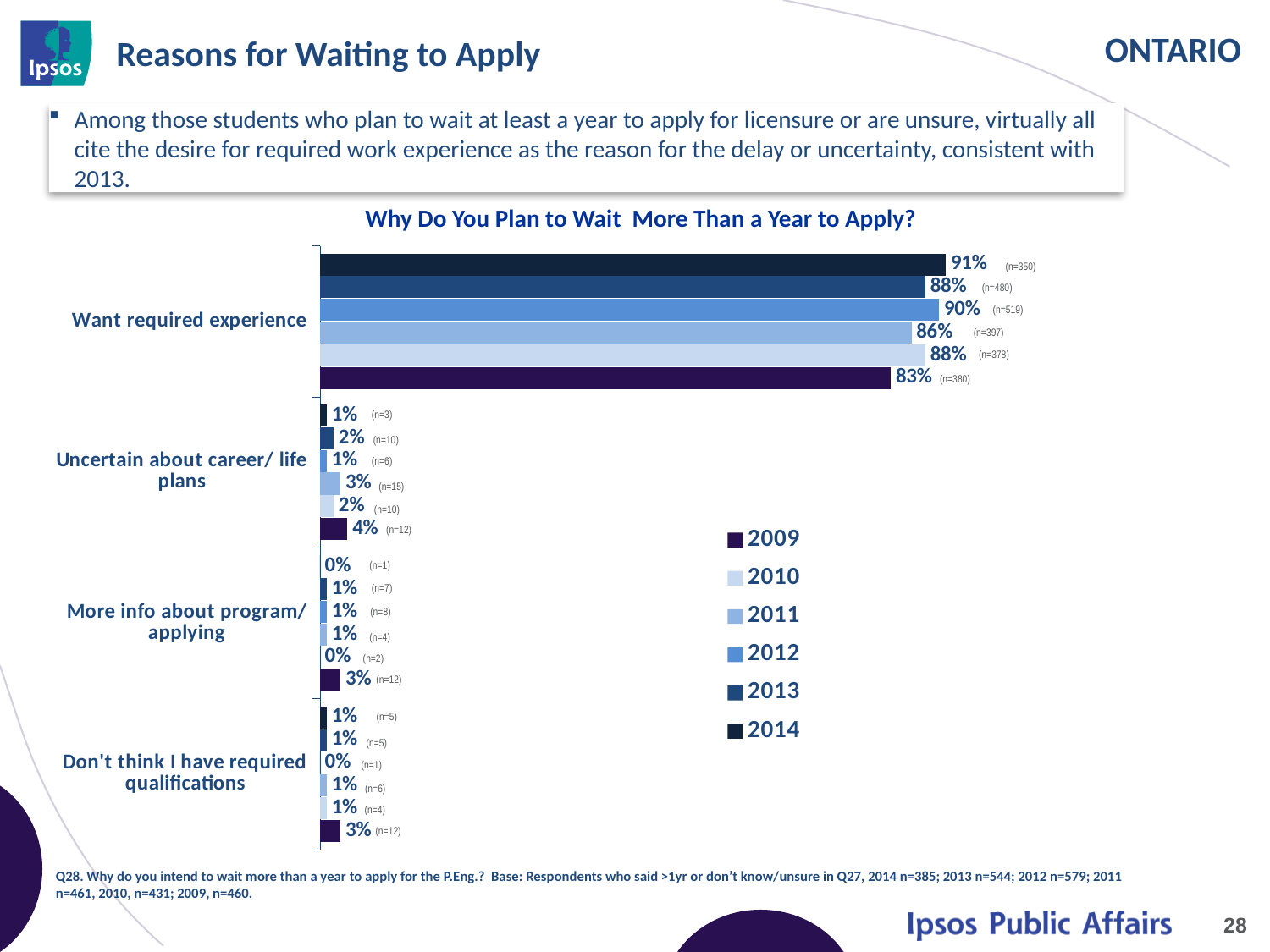
What percentage of 2009 respondents cited "Want required experience"? 83% Which reason category has the highest values across all years? Want required experience What type of chart is used on this slide? Bar chart Which year has the lowest value for "Want required experience"? 2009 What is the title of the chart? Why Do You Plan to Wait More Than a Year to Apply? How many reason categories are shown on the chart? 4 What is the difference between the 2014 and 2009 values for "Want required experience"? 8 percentage points What percentage of 2009 respondents cited "Uncertain about career/ life plans"? 4% For "Want required experience", which is larger: the 2012 value or the 2011 value? 2012 Which year has the highest value for "Want required experience"? 2014 What percentage of 2014 respondents cited "Want required experience" as their reason for waiting to apply? 91% How many years (series) does the legend list? 6